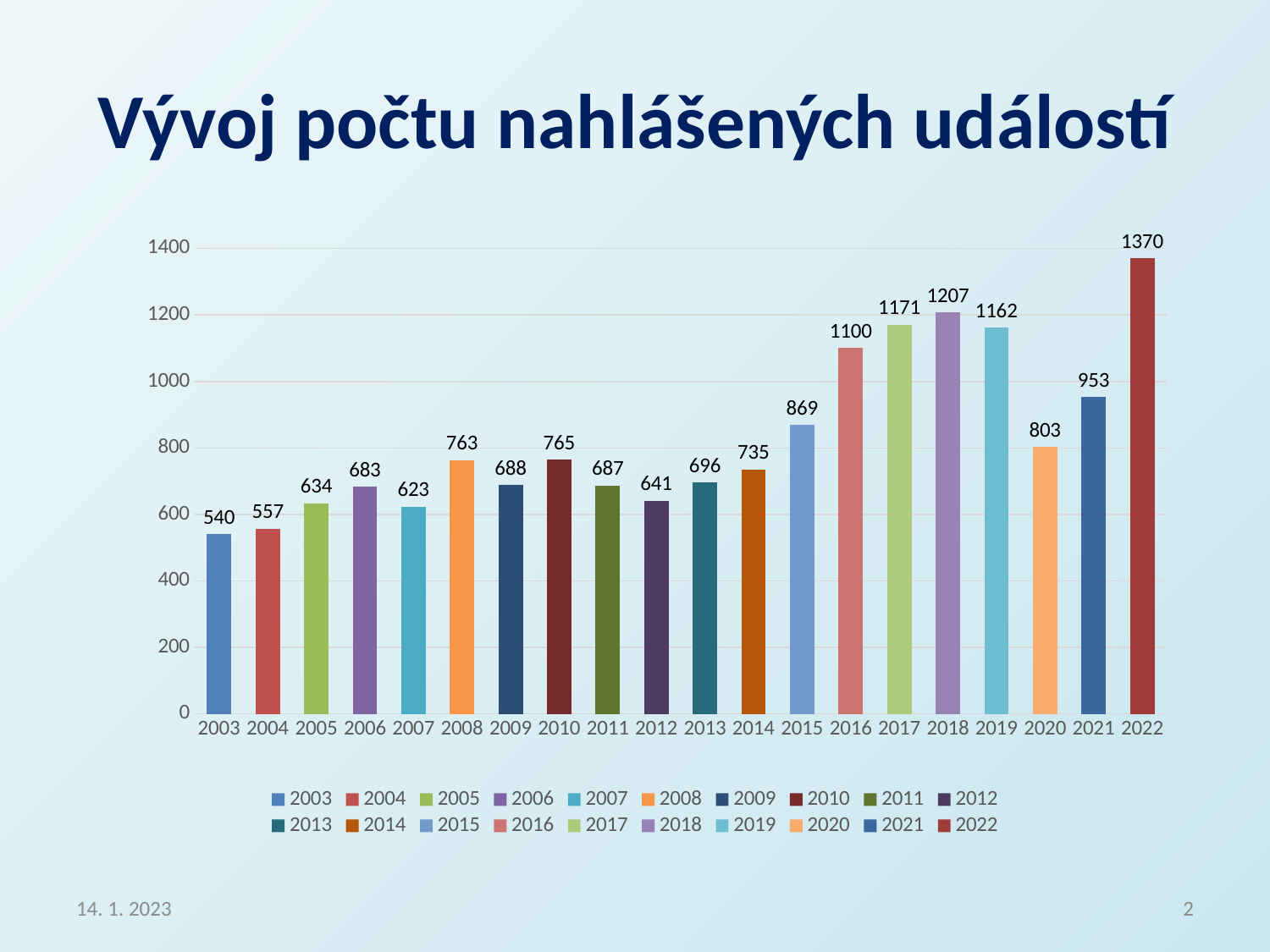
How many years are shown on the x axis? 20 What is the difference between the values for 2022 and 2021? 417 Which year has the lowest value? 2003 Which is larger, the value for 2008 or the value for 2010? 2010 What is the title of the slide? Vývoj počtu nahlášených událostí What kind of chart is shown on the slide? bar chart Is the value for 2019 greater or less than 1000? greater What is the value for 2003? 540 What is the difference between the values for 2016 and 2015? 231 What is the value for 2020? 803 What is the value for 2018? 1207 Which year has the highest value? 2022